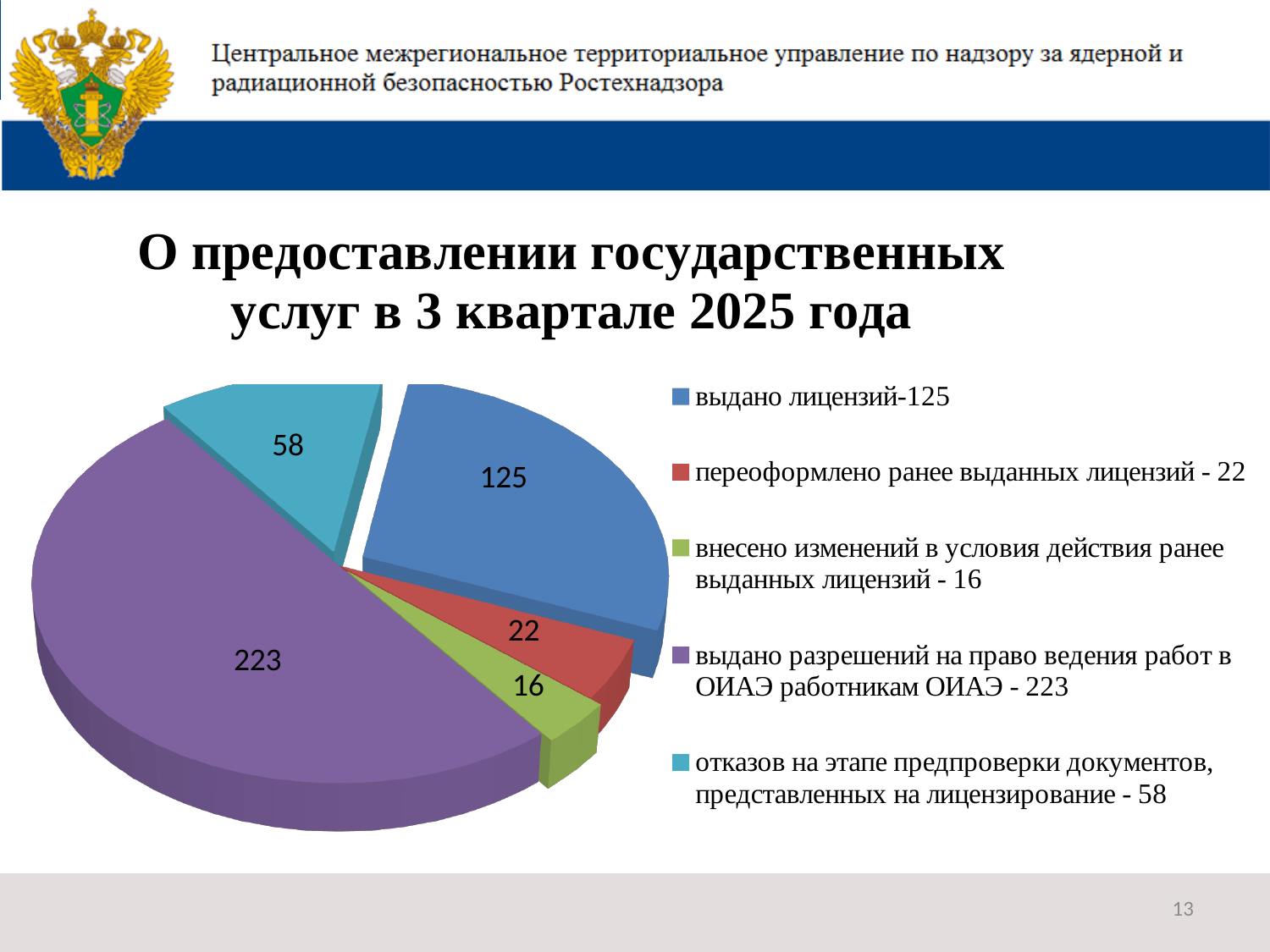
What is the value for "отказов на этапе предпроверки документов, представленных на лицензирование"? 58 What is the value for "выдано лицензий"? 125 What is the difference between the value for "выдано разрешений на право ведения работ в ОИАЭ работникам ОИАЭ" and the value for "выдано лицензий"? 98 Which category has the largest slice of the pie? выдано разрешений на право ведения работ в ОИАЭ работникам ОИАЭ What is the total of all the values shown in the pie chart? 444 What colour is the slice for "выдано разрешений на право ведения работ в ОИАЭ работникам ОИАЭ"? purple Which is larger: the value for "переоформлено ранее выданных лицензий" or the value for "внесено изменений в условия действия ранее выданных лицензий"? переоформлено ранее выданных лицензий What is the value for "переоформлено ранее выданных лицензий"? 22 How many entries does the legend list? 5 Which category has the smallest slice of the pie? внесено изменений в условия действия ранее выданных лицензий What kind of chart is shown on the slide? pie chart How many slices does the pie chart have? 5